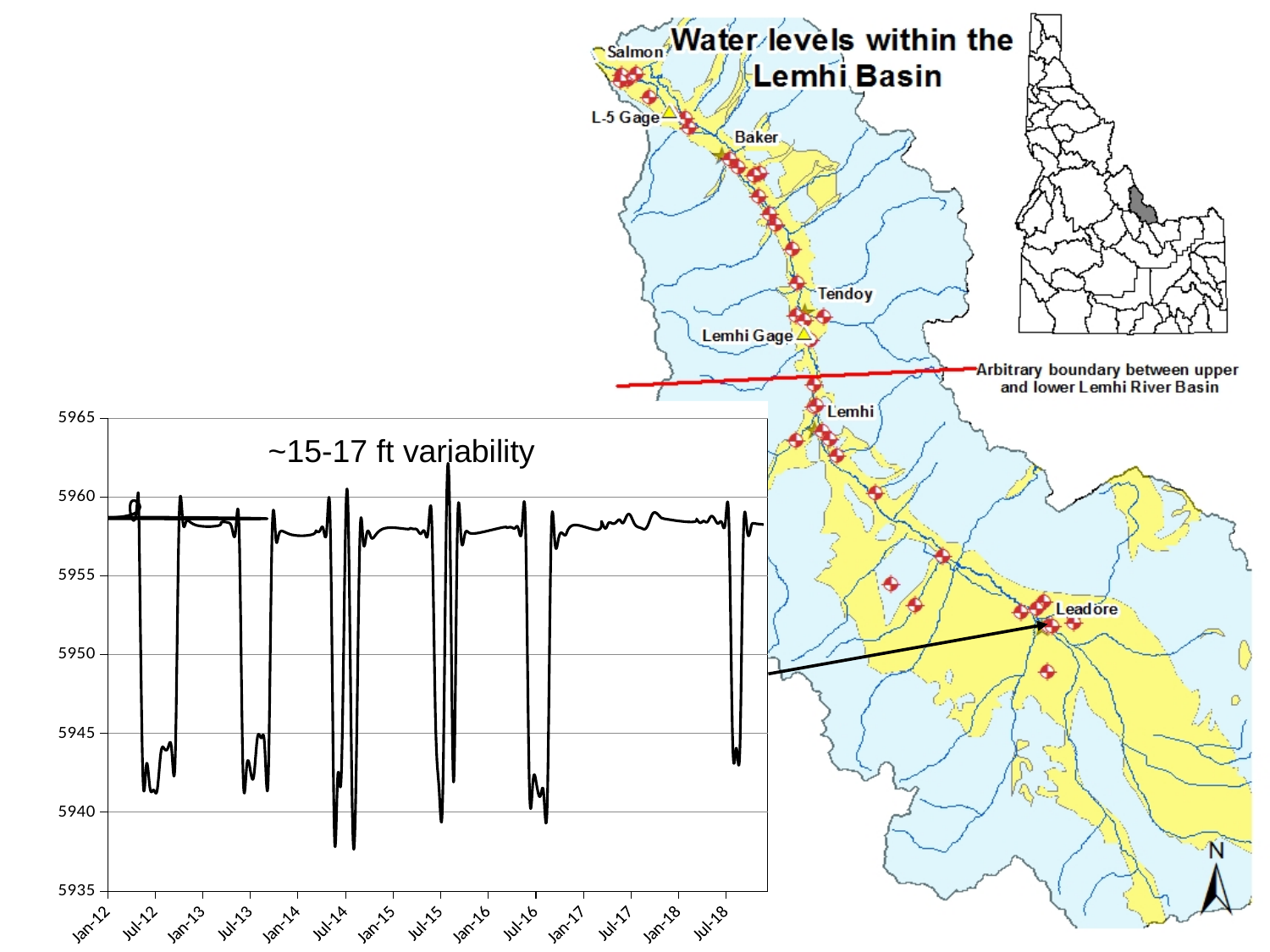
Is the value at Jan-14 on the water level chart greater or less than 5955? greater What annotation text is printed inside the water level chart? ~15-17 ft variability How many lines (series) are plotted on the water level chart? 1 Is the value at Jan-18 on the water level chart greater or less than 5955? greater Which dip is deeper on the water level chart, the one near Jul-14 or the one near Jul-13? Jul-14 Is the lowest value reached near Jul-14 on the water level chart greater or less than 5940? less What is the lowest value shown on the y axis of the water level chart? 5935 What kind of chart is shown on the left of the slide? line chart How many date labels are shown along the x axis of the water level chart? 14